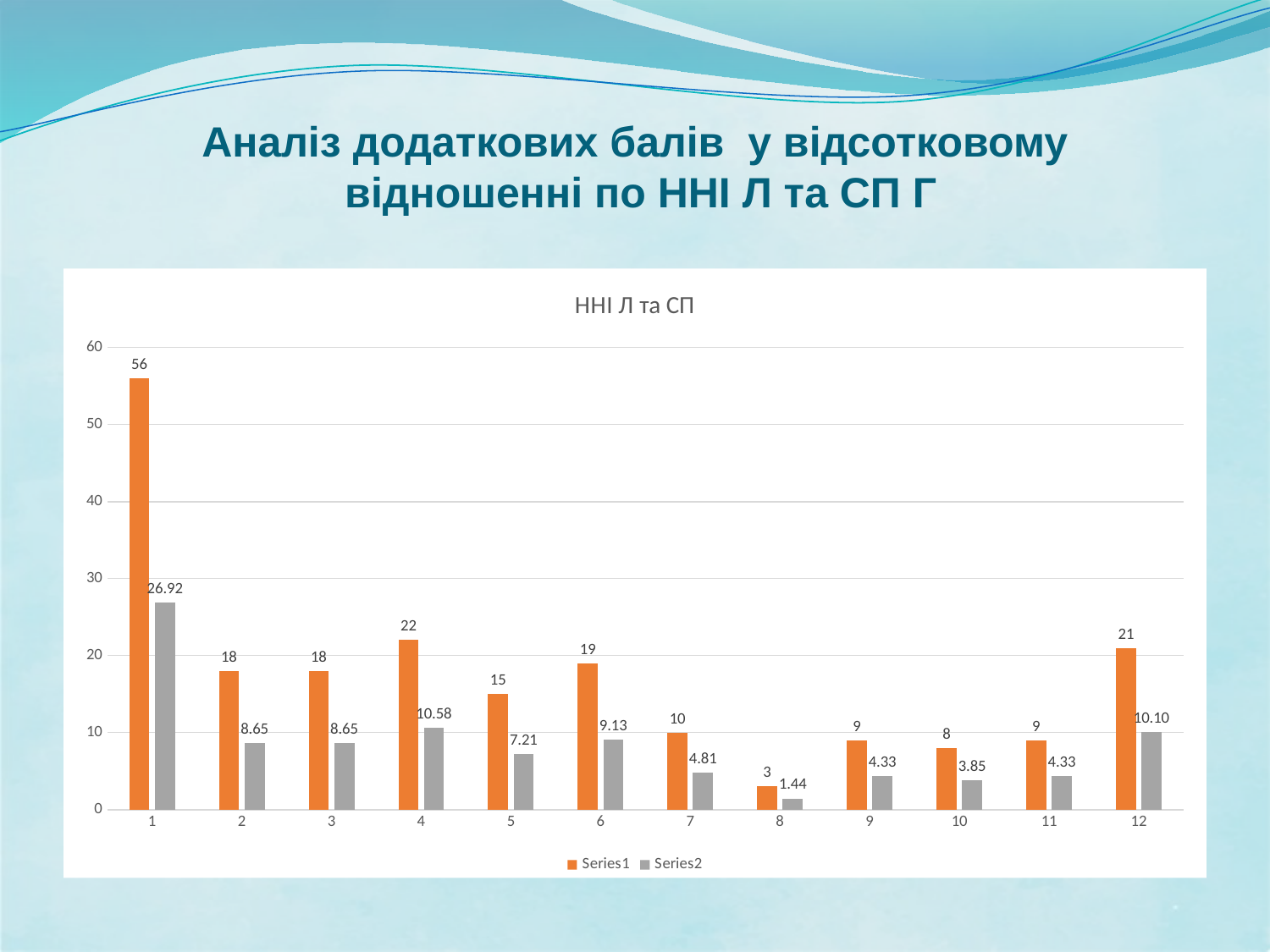
Which is larger, the Series1 value for category 6 or for category 5? category 6 What is the difference between the Series1 values for category 4 and category 12? 1 What is the difference between the Series2 values for category 1 and category 12? 16.82 What kind of chart is shown on the slide? bar chart How many categories are shown on the x axis? 12 Which category has the lowest Series2 value? 8 What is the Series2 value for category 4? 10.58 How many series does the legend list? 2 Which category has the highest Series1 value? 1 What is the Series1 value for category 1? 56 What is the Series2 value for category 8? 1.44 What is the title of the chart? ННІ Л та СП